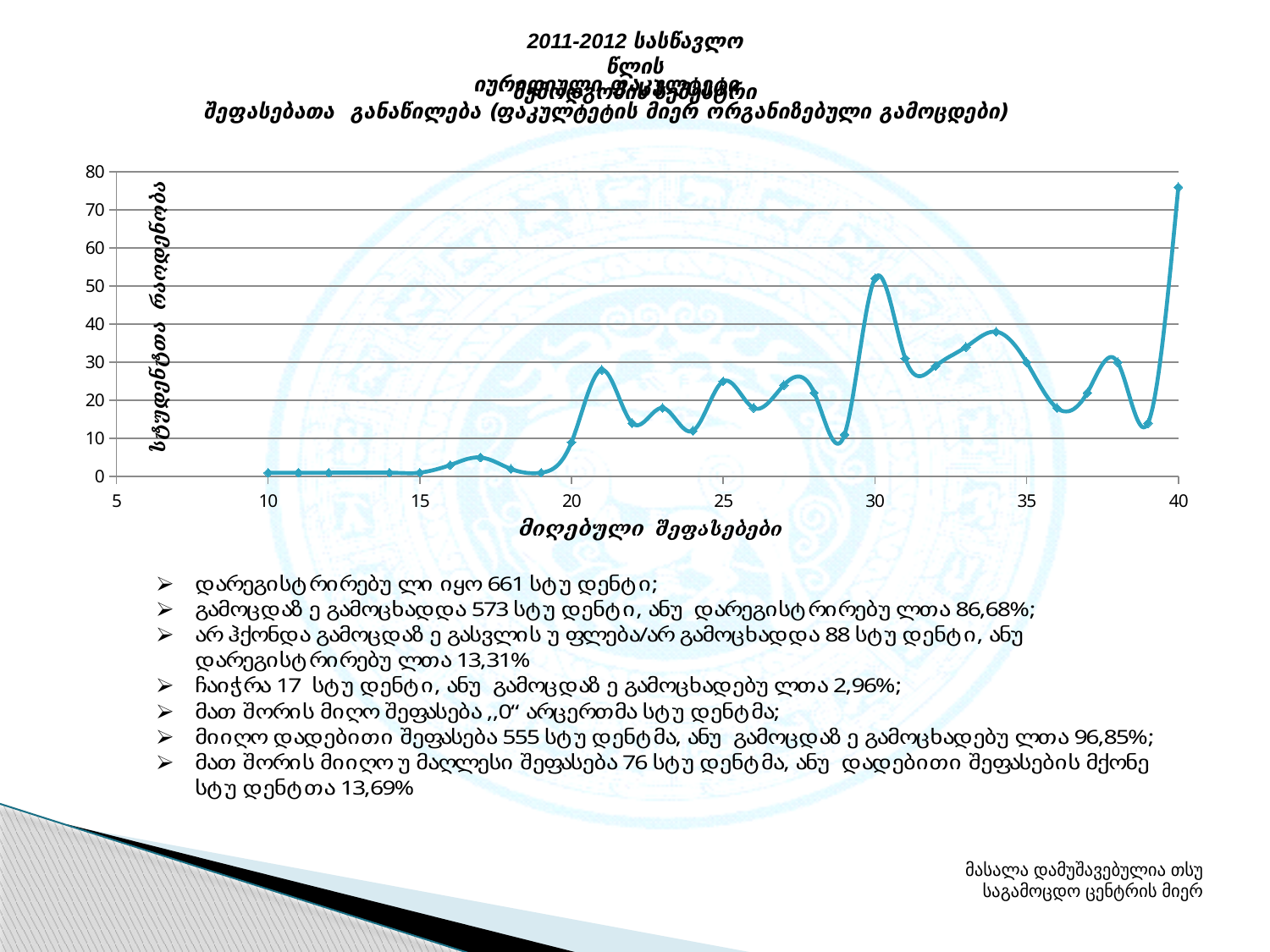
At which x-axis value (received grade) does the line reach its highest point? 40 Which has the larger value, x = 30 or x = 31? 30 Which has the larger value, x = 21 or x = 29? 21 Is the value at x = 10 greater or less than 10? less Is the value at x = 30 greater or less than 40? greater Is the value at x = 40 greater or less than 70? greater Which has the larger value, x = 30 or x = 40? 40 What is the label on the vertical axis of the chart? სტუდენტთა რაოდენობა What is the label on the horizontal axis of the chart? მიღებული შეფასებები What kind of chart is shown on the slide? line chart